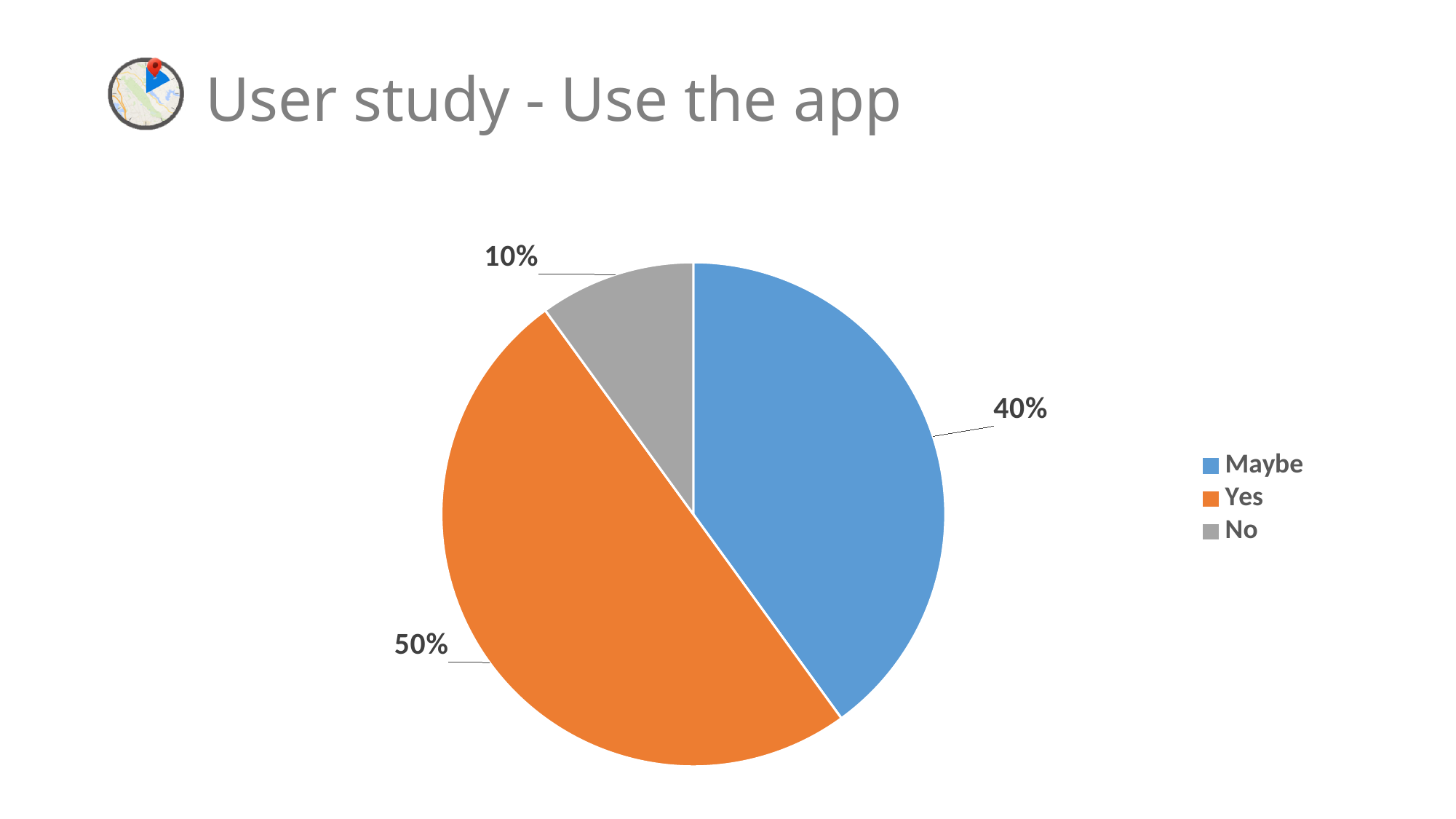
What type of chart is shown on the slide? pie chart What percentage of the pie is labelled for the Yes slice? 50% How many entries does the legend list? 3 How many slices does the pie chart have? 3 What percentage of the pie is labelled for the Maybe slice? 40% What colour is the Yes slice in the pie chart? orange What is the difference in percentage points between the Yes and Maybe slices? 10% What is the difference in percentage points between the Maybe and No slices? 30% Which slice is larger, Yes or Maybe? Yes Which category has the largest share of the pie? Yes What percentage of the pie is labelled for the No slice? 10% Which category has the smallest share of the pie? No